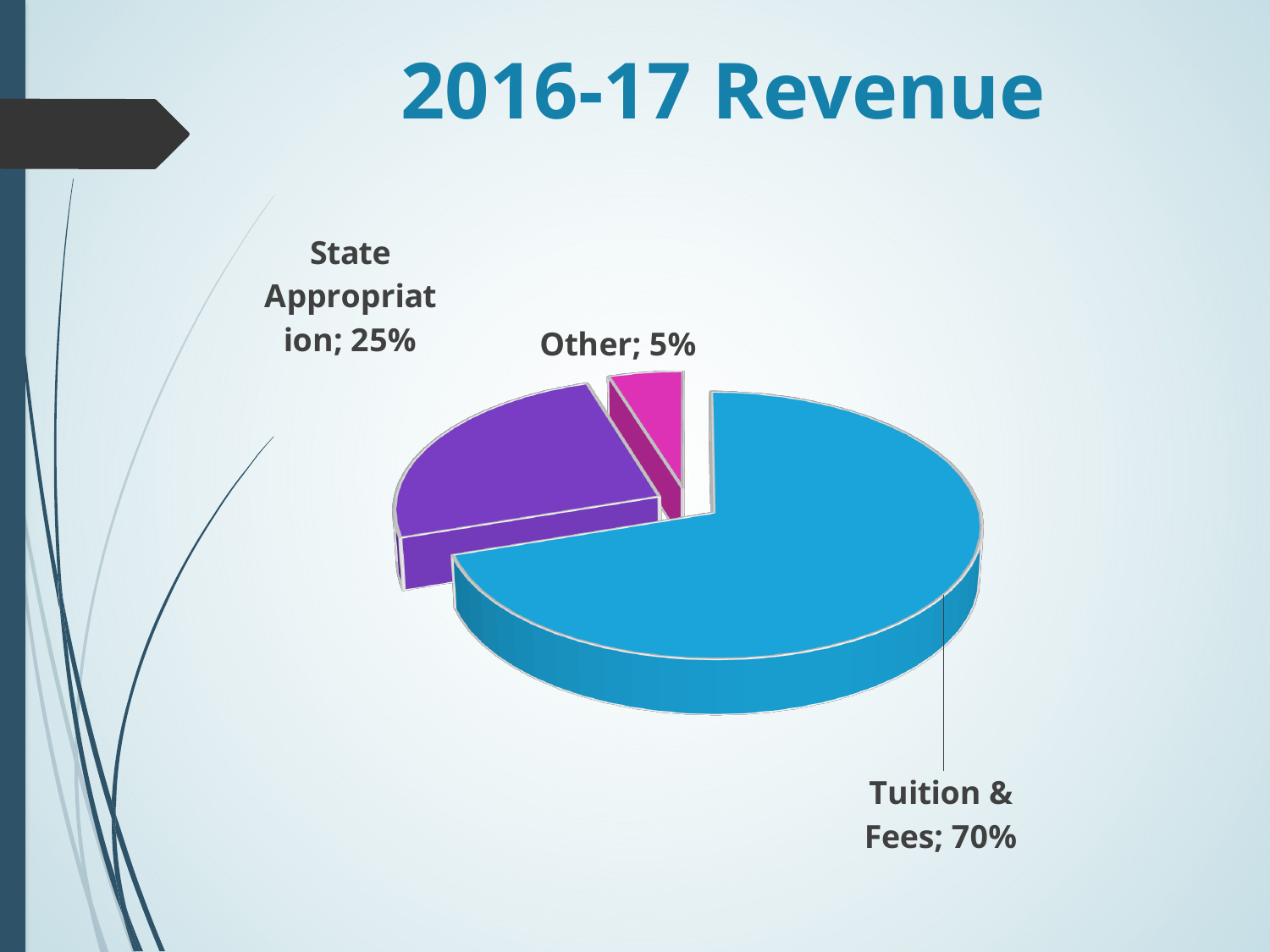
How many percentage points larger is the State Appropriation share than the Other share? 20 How many percentage points larger is the Tuition & Fees share than the State Appropriation share? 45 What is the title of the chart? 2016-17 Revenue What share of 2016-17 revenue comes from Tuition & Fees? 70% What share of 2016-17 revenue comes from State Appropriation? 25% How many slices does the pie chart have? 3 Which is larger, the share for State Appropriation or the share for Other? State Appropriation What colour is the Tuition & Fees slice? Blue Which revenue source has the largest share of the pie? Tuition & Fees What share of 2016-17 revenue is labelled Other? 5% What kind of chart is shown on the slide? Pie chart Which revenue source has the smallest share of the pie? Other